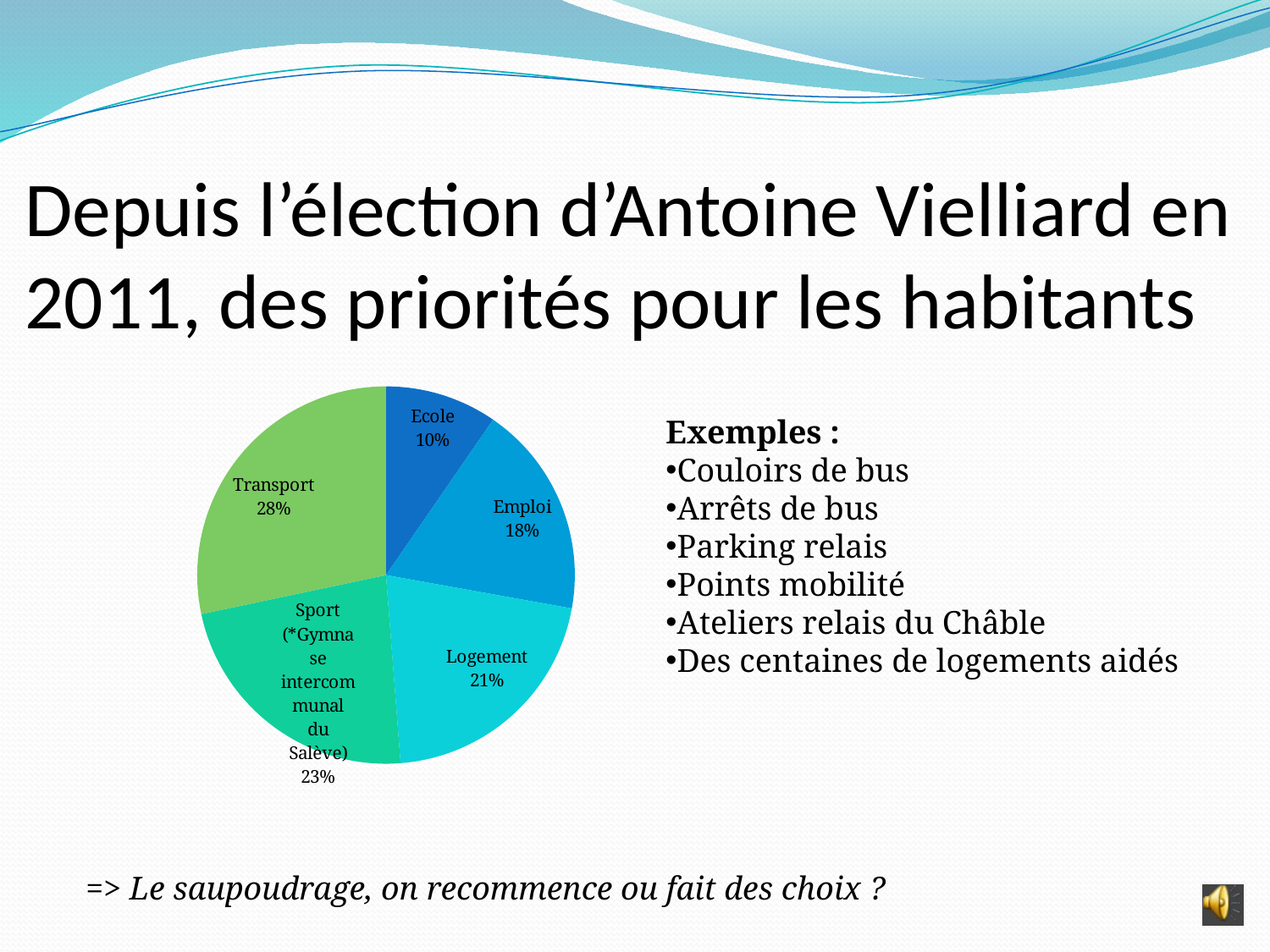
What is the difference in percentage points between Sport and Logement? 2 What is the value shown for Ecole? 10% Which category has the smallest slice of the pie? Ecole What is the difference in percentage points between Transport and Ecole? 18 How many slices does the pie chart have? 5 What is the value shown for Emploi? 18% What kind of chart is shown on the slide? pie chart What is the value shown for the Sport slice? 23% Which is larger, Logement or Emploi? Logement Which category has the largest slice of the pie? Transport What share of the pie does Transport have? 28% What is the value shown for Logement? 21%